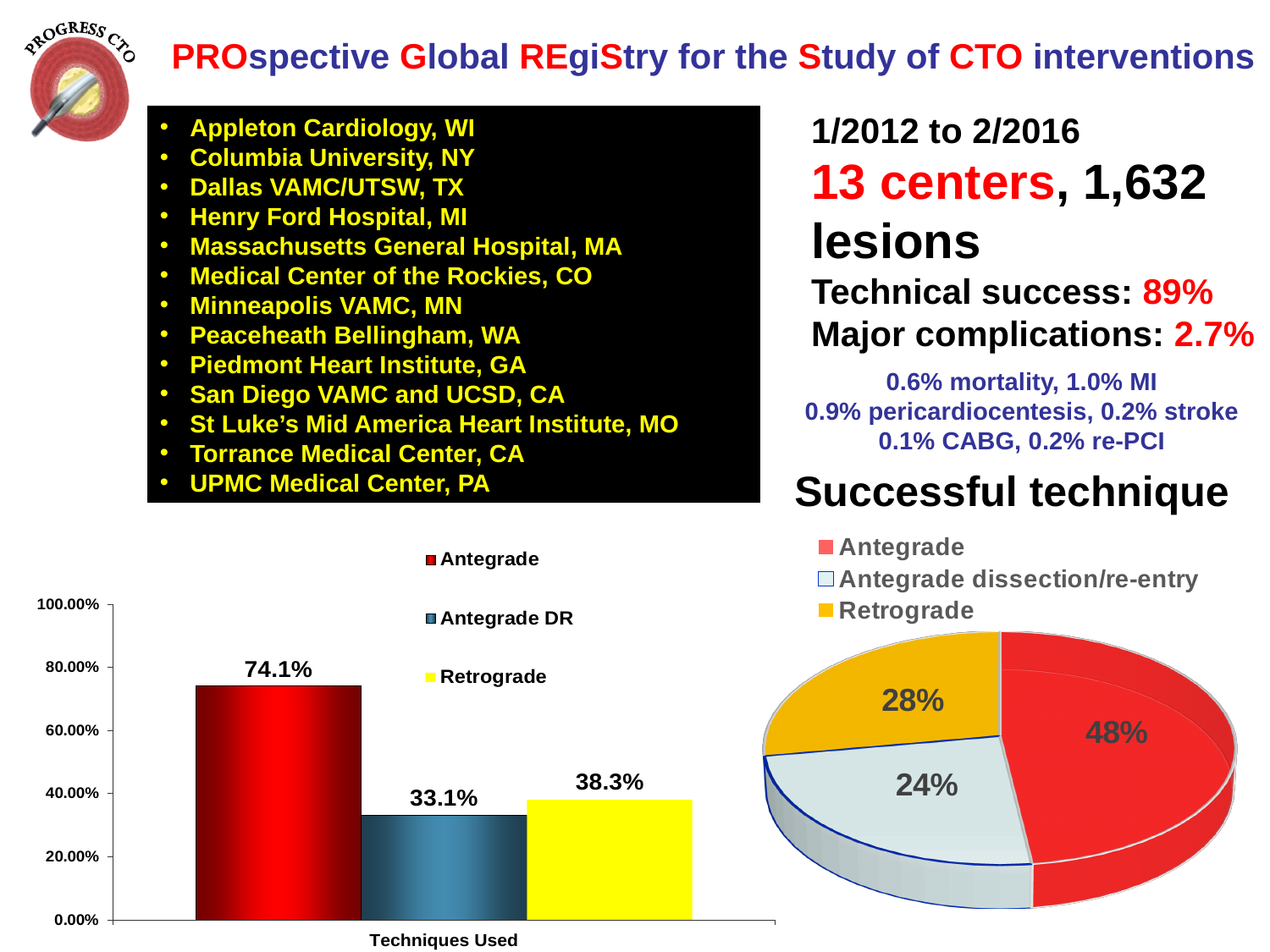
In the Successful technique pie chart, what share does Antegrade have? 48% In the bar chart labelled Techniques Used, how many series does the legend list? 3 What kind of chart is the one labelled Techniques Used? Bar chart In the Successful technique pie chart, what colour is the Retrograde slice? Orange In the Successful technique pie chart, what share does Antegrade dissection/re-entry have? 24% In the Successful technique pie chart, which slice is the largest? Antegrade In the bar chart labelled Techniques Used, which technique has the lowest value? Antegrade DR In the Successful technique pie chart, is the Retrograde slice larger or smaller than the Antegrade dissection/re-entry slice? Larger In the bar chart labelled Techniques Used, which technique has the highest value? Antegrade In the bar chart labelled Techniques Used, what is the value for Retrograde? 38.3% In the bar chart labelled Techniques Used, what is the difference between the Antegrade and Antegrade DR values? 41.0% In the bar chart labelled Techniques Used, what is the value for Antegrade? 74.1%